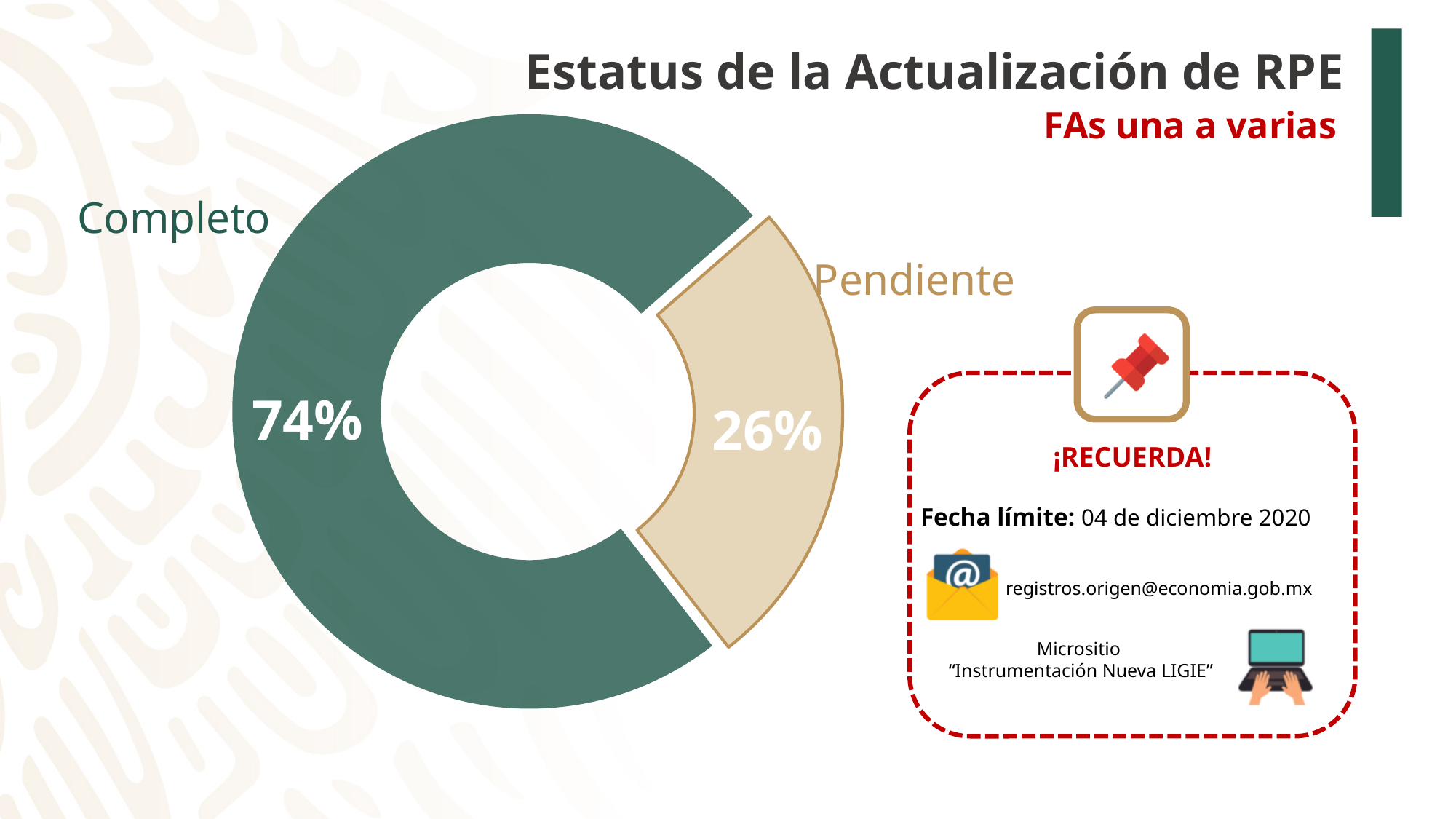
What is the total of the two percentages shown in the chart? 100% What colour is the Completo segment of the chart? Dark green Which category has the smallest share of the chart? Pendiente Which category has the largest share of the chart? Completo Which is larger, Completo or Pendiente? Completo What is the title of the slide containing the chart? Estatus de la Actualización de RPE What share of the chart does the Pendiente slice represent? 26% What is the difference in percentage points between Completo and Pendiente? 48 What kind of chart is shown on the slide? Doughnut (pie) chart What percentage is shown for Completo? 74% How many categories does the chart show? 2 What percentage is shown for Pendiente? 26%